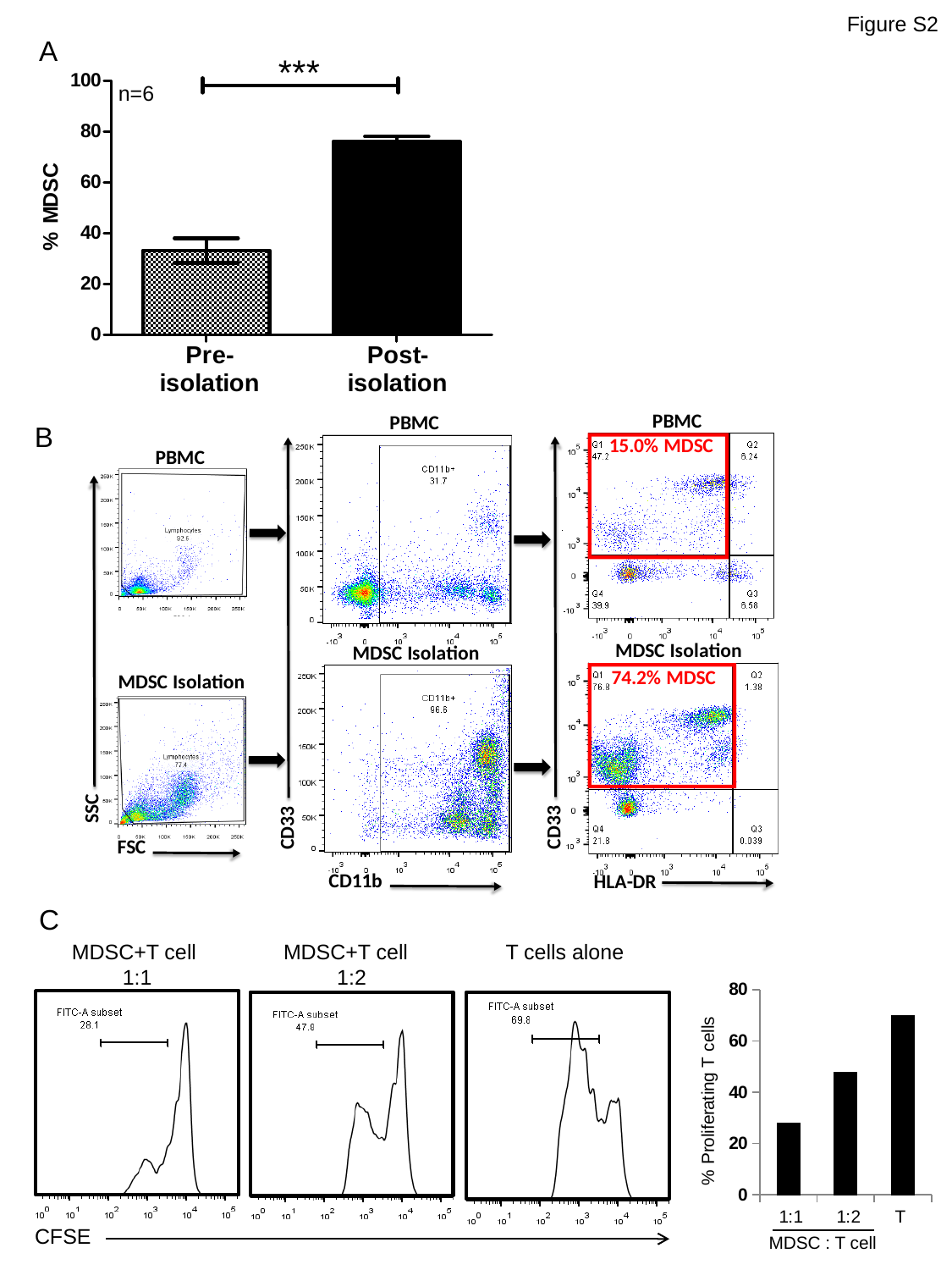
What is the y-axis label of the panel A bar chart? % MDSC In the panel A bar chart, which category has the higher % MDSC? Post-isolation In the panel C bar chart of % Proliferating T cells, which category has the highest value? T In the panel A bar chart, is the value for Pre-isolation greater or less than 40? less In the panel C bar chart, do the values rise or fall going from 1:1 to 1:2 to T along the x axis? rise What kind of chart is shown in panel A? bar chart What sample size is annotated on the panel A bar chart? n=6 In the panel A bar chart, is the value for Post-isolation greater or less than 60? greater How many bars are plotted in the panel A bar chart? 2 How many categories are plotted in the panel C bar chart of % Proliferating T cells? 3 In the panel C bar chart, is the value for 1:2 greater or less than 40? greater In the panel C bar chart of % Proliferating T cells, which category has the lowest value? 1:1